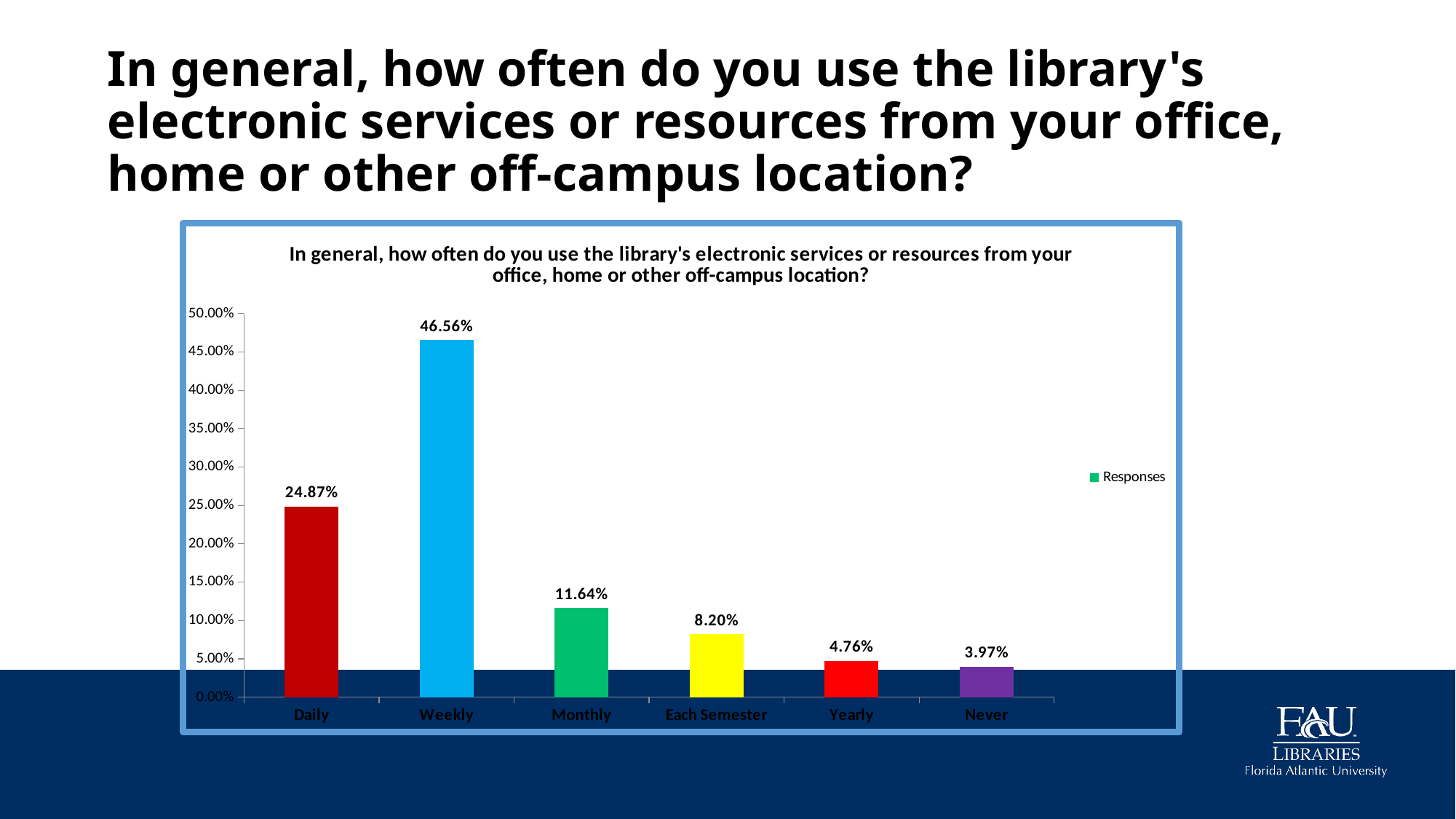
How many categories are shown on the x axis? 6 Which is larger, the value for Monthly or the value for Each Semester? Monthly Is the value for Daily greater or less than 20.00%? greater Which category has the highest value? Weekly Which category has the lowest value? Never How many series does the legend list? 1 What is the value shown for Daily? 24.87% What percentage of respondents use the library's electronic services weekly? 46.56% What kind of chart is shown on the slide? Bar chart What is the value shown for Each Semester? 8.20% What is the difference between the Monthly and Yearly values? 6.88% What is the difference between the Weekly and Daily values? 21.69%